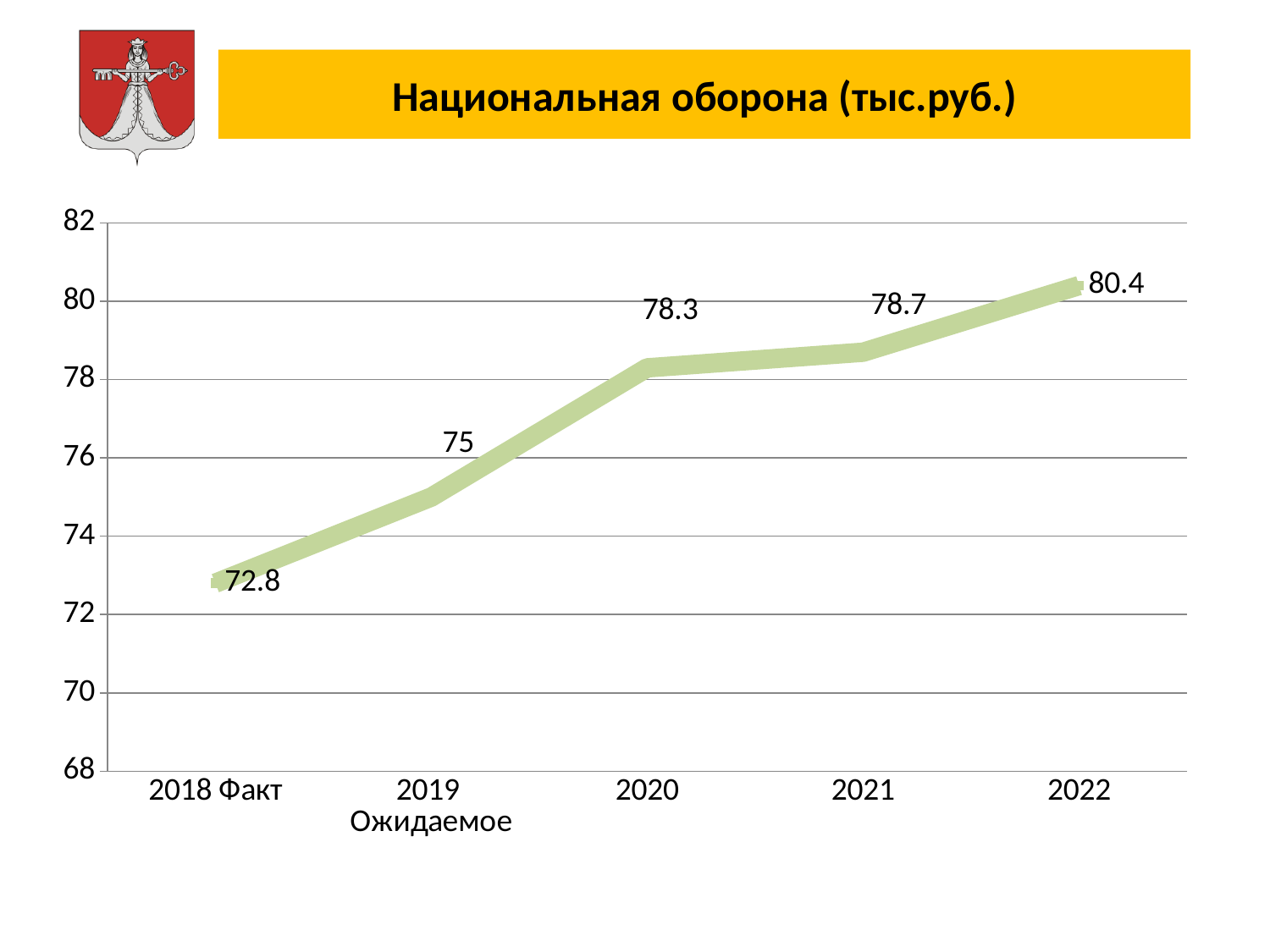
Do the values rise or fall from 2018 Факт to 2022? rise Is the value for 2019 Ожидаемое greater or less than 76? less Which year has the highest value? 2022 How many data points are plotted on the chart? 5 Which category has the lowest value? 2018 Факт What is the difference between the values for 2022 and 2018 Факт? 7.6 What is the value for 2019 Ожидаемое? 75 What is the value for 2020? 78.3 What is the value for 2022? 80.4 What kind of chart is shown on the slide? line chart Which is larger, the value for 2021 or the value for 2020? 2021 What is the value for 2018 Факт? 72.8